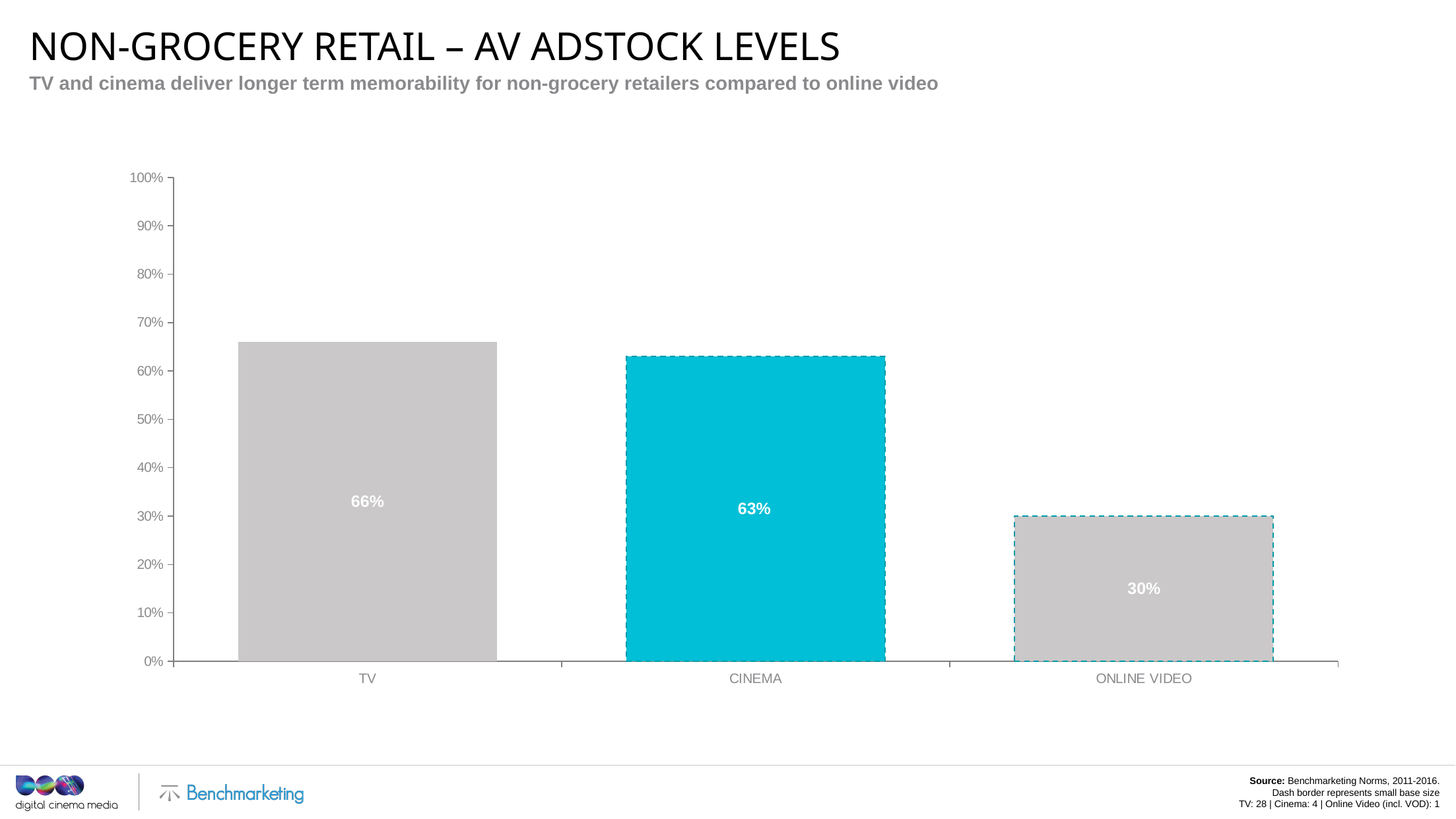
Which has a higher adstock level, Cinema or Online Video? Cinema What kind of chart is shown on the slide? Bar chart Is the value for Cinema greater or less than 50%? greater What is the AV adstock level for TV? 66% Which category has the highest AV adstock level? TV How many categories are shown in the chart? 3 What is the difference between the TV and Online Video adstock levels? 36% Which bar is coloured teal rather than grey? Cinema What is the AV adstock level for Online Video? 30% What is the AV adstock level for Cinema? 63% What is the difference between the TV and Cinema adstock levels? 3% Which category has the lowest AV adstock level? Online Video